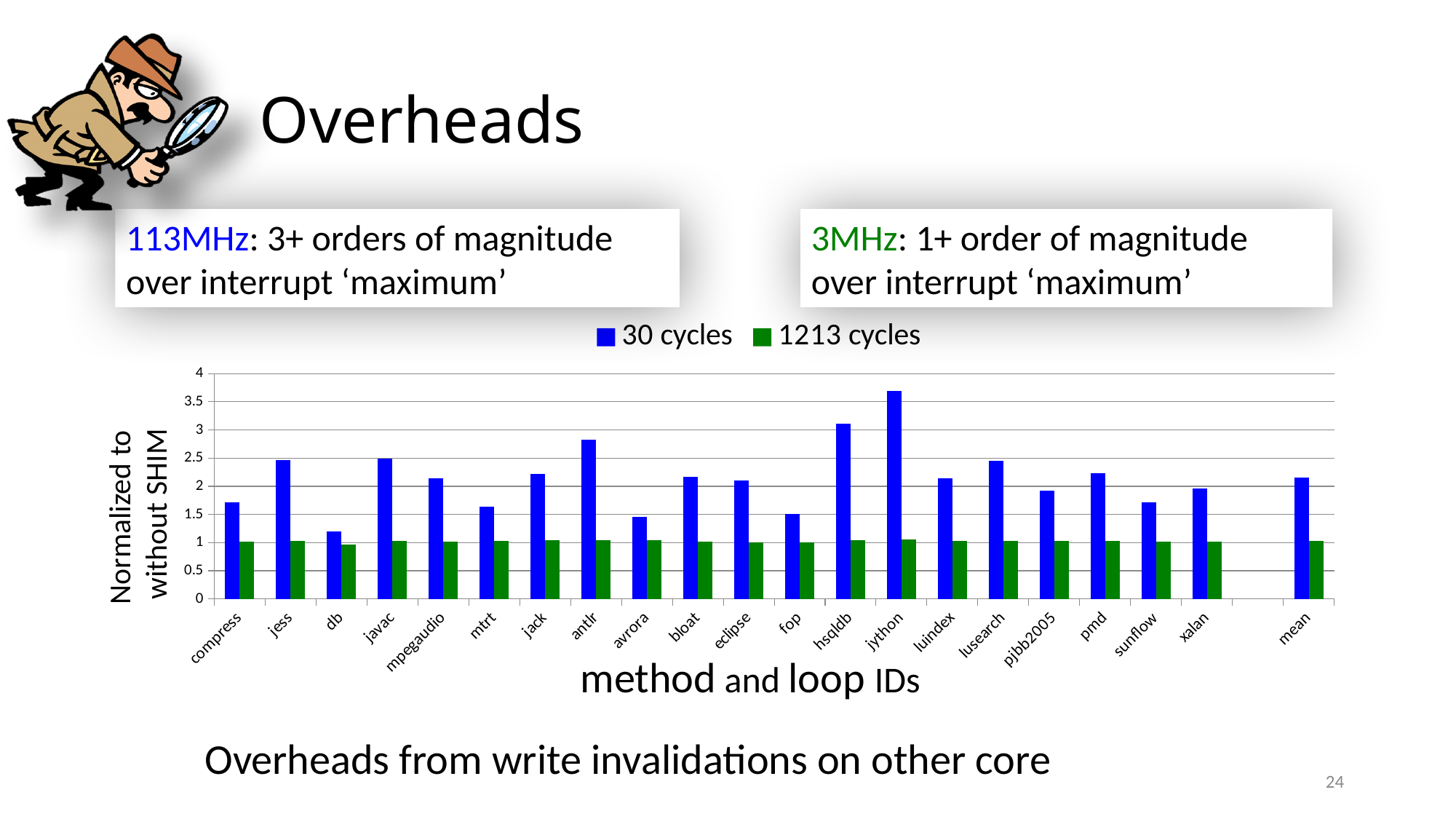
Is the 30 cycles value for hsqldb greater or less than 3? greater What colour are the bars for the 1213 cycles series? green Is the 30 cycles value for mean greater or less than 2? greater How many series does the legend list? 2 Is the 30 cycles value for antlr greater or less than 2.5? greater Which has the larger 30 cycles value, antlr or avrora? antlr How many categories are shown along the x axis? 21 What kind of chart is shown on the slide? bar chart Which category has the lowest value for the 30 cycles series? db Which category has the highest value for the 30 cycles series? jython